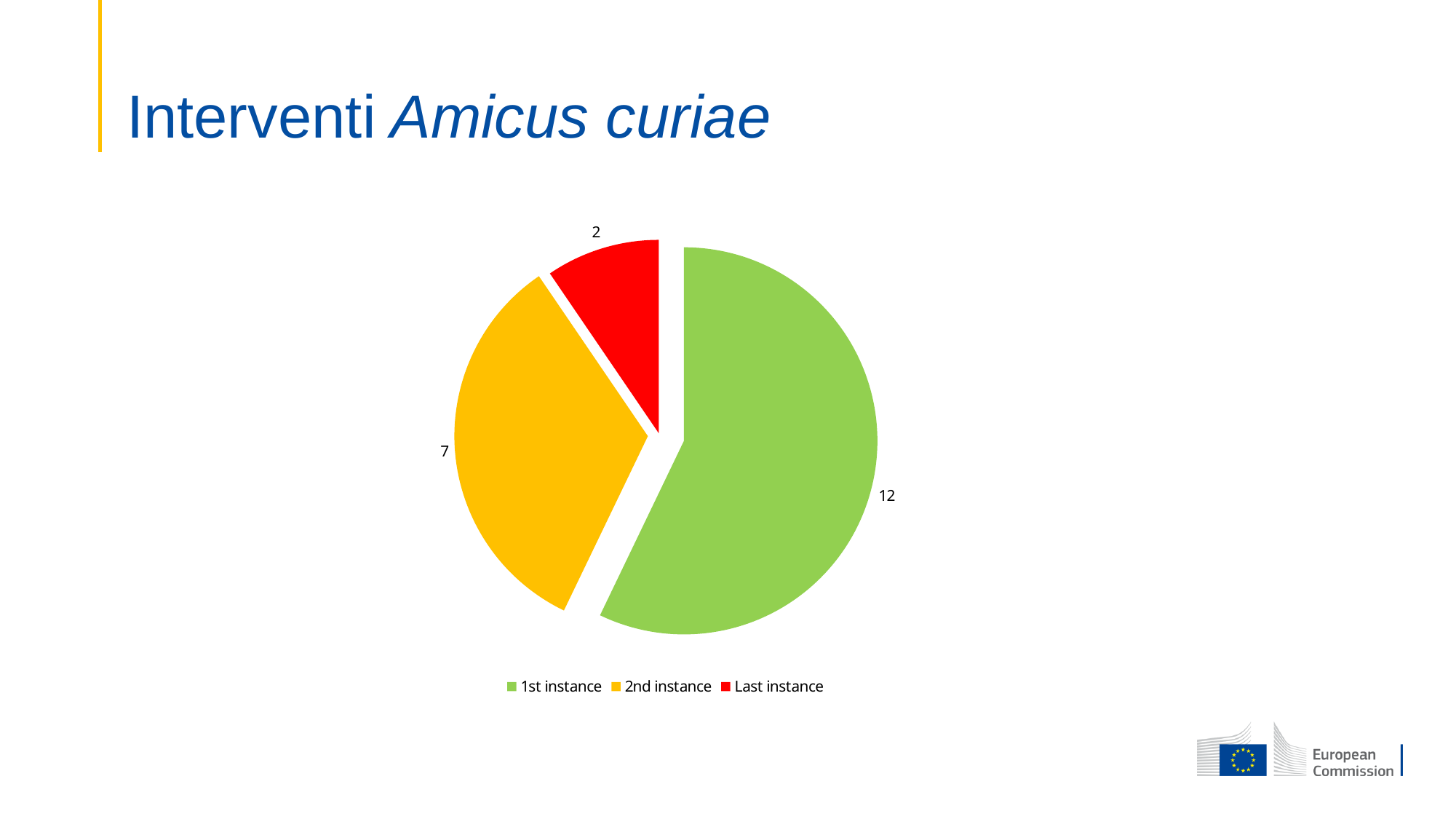
What is the value for 2nd instance? 7 What colour is the slice for Last instance? red Which category has the smallest slice? Last instance Which is larger, the value for 2nd instance or Last instance? 2nd instance What is the difference between the values for 1st instance and 2nd instance? 5 Which category has the largest slice? 1st instance What is the total of all slices in the pie chart? 21 What is the value for Last instance? 2 What kind of chart is shown on the slide? pie chart What is the title of the slide containing the chart? Interventi Amicus curiae How many slices does the pie chart have? 3 What is the value for 1st instance? 12